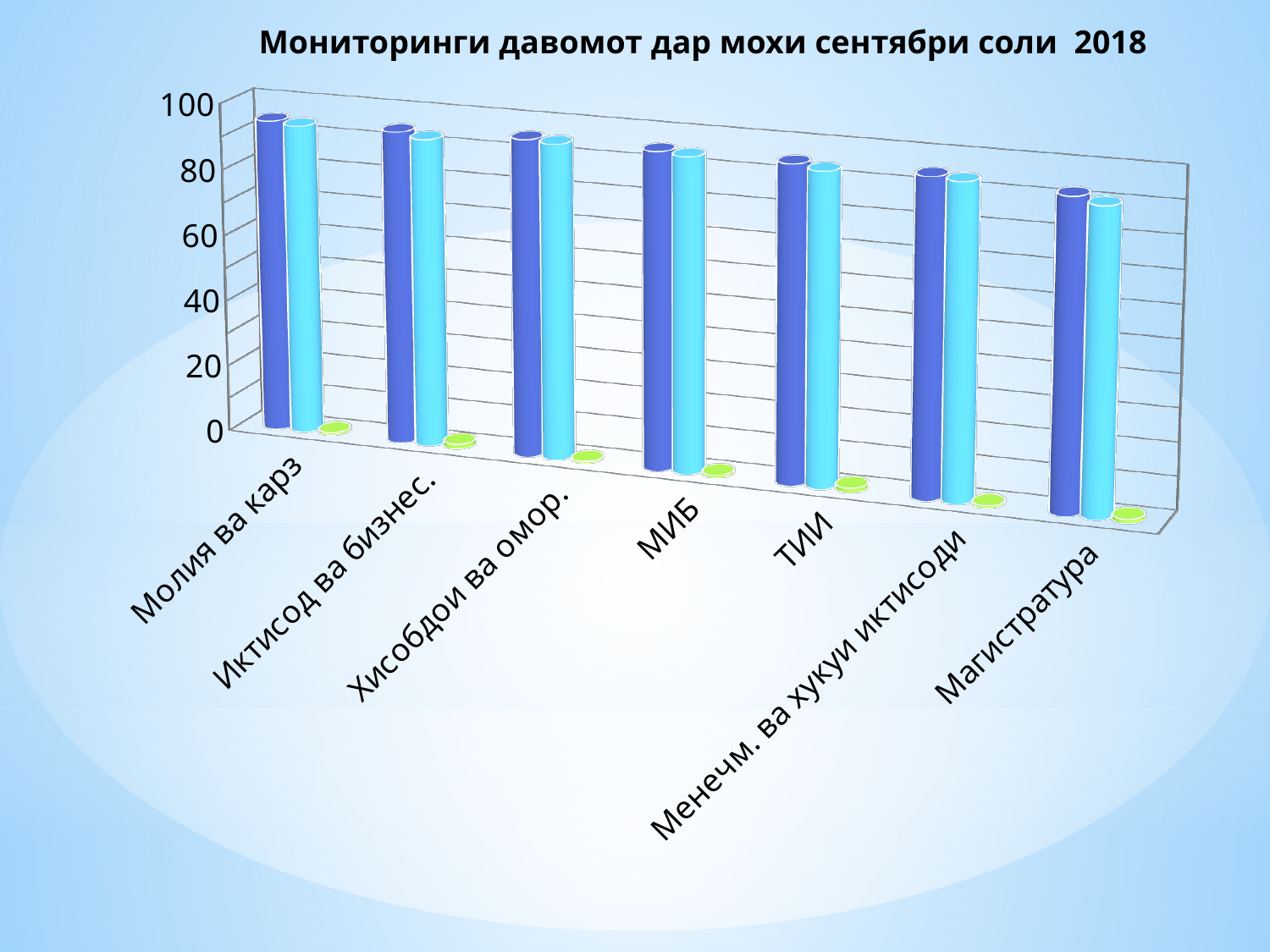
Is the green value for МИБ greater or less than 20? less Is the dark blue value for Молия ва карз greater or less than 60? greater How many bars are plotted for each category in the chart? 3 Which category has the lowest blue bars in the chart? Магистратура What is the title of the chart? Мониторинги давомот дар мохи сентябри соли 2018 Which has a larger dark blue bar, Молия ва карз or Магистратура? Молия ва карз Is the dark blue value for Магистратура greater or less than 40? greater How many categories are shown on the x axis of the chart? 7 What kind of chart is shown on the slide? bar chart